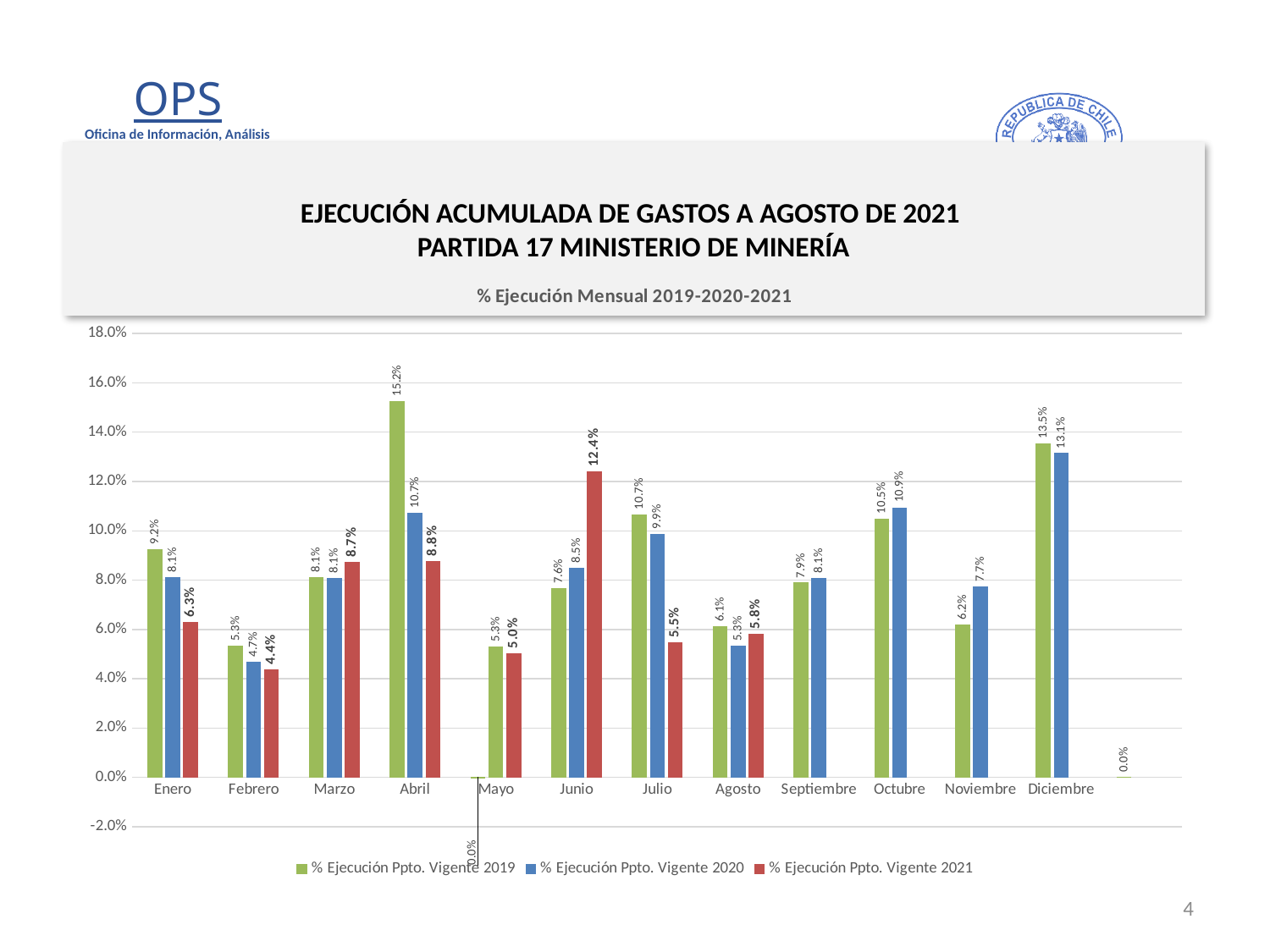
What is the value for % Ejecución Ppto. Vigente 2021 in Marzo? 8.7% What kind of chart is shown on the slide? bar chart In which month is the % Ejecución Ppto. Vigente 2020 value lowest? Febrero What is the value for % Ejecución Ppto. Vigente 2020 in Octubre? 10.9% Which legend entry is shown in red? % Ejecución Ppto. Vigente 2021 In Julio, which series has the larger value: % Ejecución Ppto. Vigente 2019 or % Ejecución Ppto. Vigente 2020? % Ejecución Ppto. Vigente 2019 What is the difference between the 2019 and 2020 values in Abril? 4.5 percentage points How many series does the legend list? 3 What is the value for % Ejecución Ppto. Vigente 2021 in Junio? 12.4% How many months are shown on the x axis? 12 In which month is the % Ejecución Ppto. Vigente 2019 value highest? Abril Is the value for % Ejecución Ppto. Vigente 2019 in Diciembre greater or less than 12.0%? greater